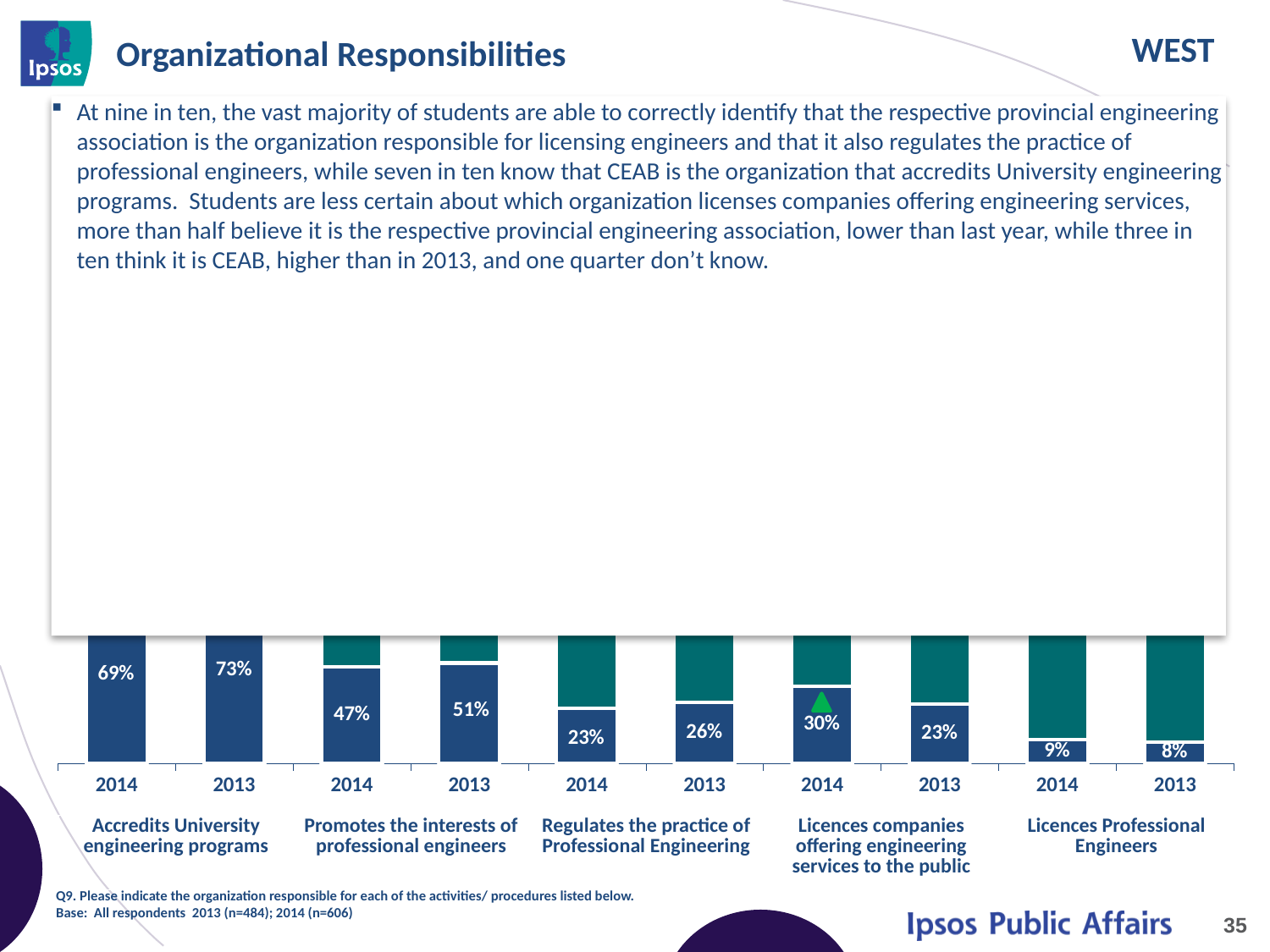
How many activity categories are shown along the x axis of the chart? 5 What is the difference between the 2014 and 2013 dark blue values under "Licences companies offering engineering services to the public"? 7 percentage points Which bar has the lowest dark blue labelled value on the chart? 2013, Licences Professional Engineers (8%) Under "Regulates the practice of Professional Engineering", is the dark blue value larger for 2014 or 2013? 2013 Which bar has the highest dark blue labelled value on the chart? 2013, Accredits University engineering programs (73%) What is the title of the slide containing the chart? Organizational Responsibilities What is the dark blue value labelled for 2013 under "Licences Professional Engineers"? 8% What is the dark blue value labelled for 2013 under "Promotes the interests of professional engineers"? 51% What kind of chart is shown on the slide? Stacked bar chart What is the difference between the 2013 and 2014 dark blue values under "Accredits University engineering programs"? 4 percentage points What is the dark blue value labelled for 2014 under "Accredits University engineering programs"? 69% What is the dark blue value labelled for 2014 under "Licences companies offering engineering services to the public"? 30%